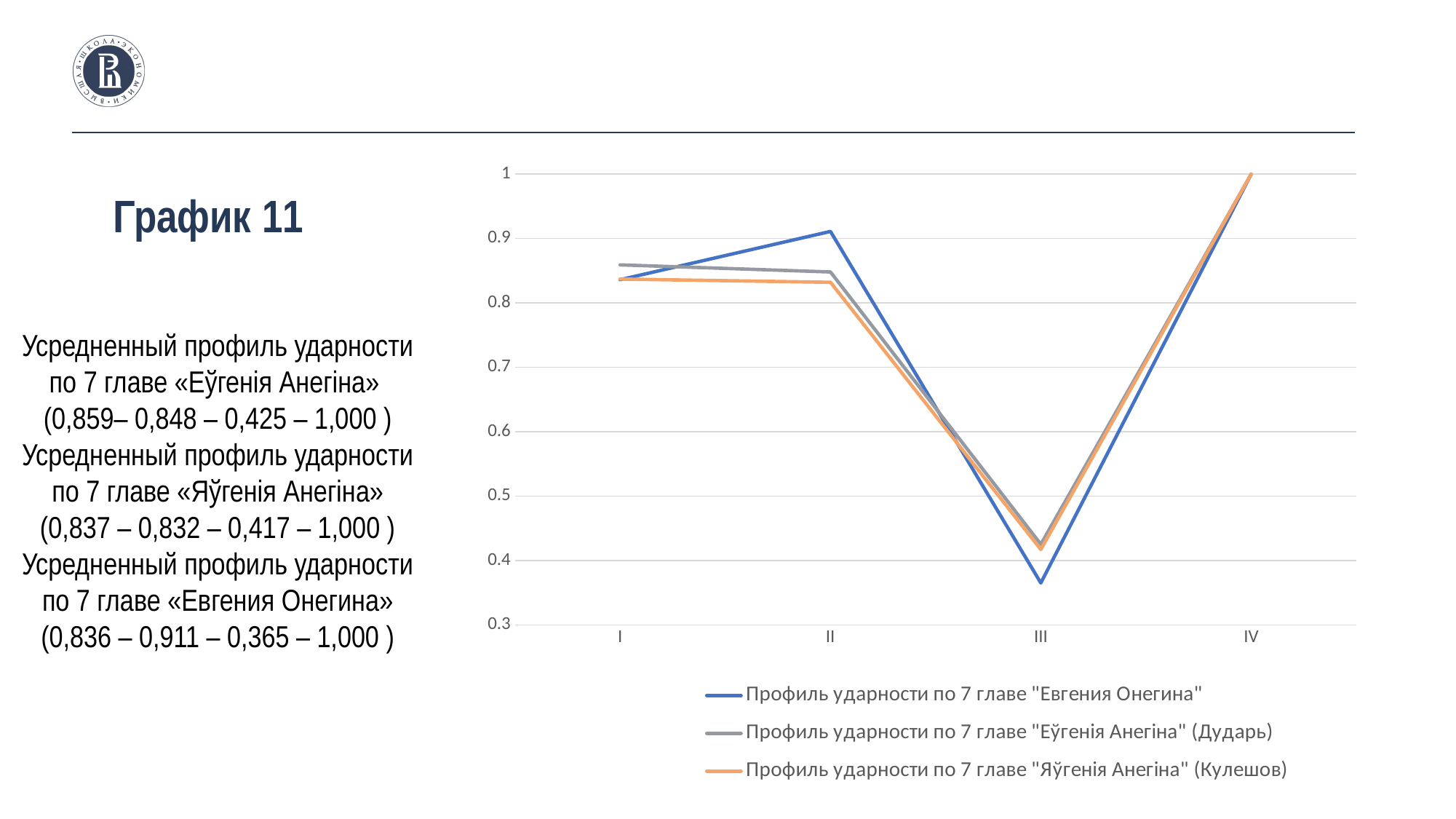
What is the value of the "Яўгенія Анегіна" (Кулешов) profile at point I? 0,837 Which is larger at point II: the "Евгения Онегина" profile or the "Еўгенія Анегіна" (Дударь) profile? Евгения Онегина At which point do all three profiles reach their highest value? IV How many points are on the x axis of the chart? 4 Is the value of the "Евгения Онегина" profile at point III greater or less than 0.4? less How many series does the legend list? 3 What is the value of the "Еўгенія Анегіна" (Дударь) profile at point III? 0,425 What is the difference between the "Евгения Онегина" profile values at points II and III? 0,546 At which point does the "Евгения Онегина" profile reach its lowest value? III Do the lines rise or fall from point II to point III? fall What kind of chart is shown on the slide? line chart What is the value of the "Евгения Онегина" profile at point II? 0,911